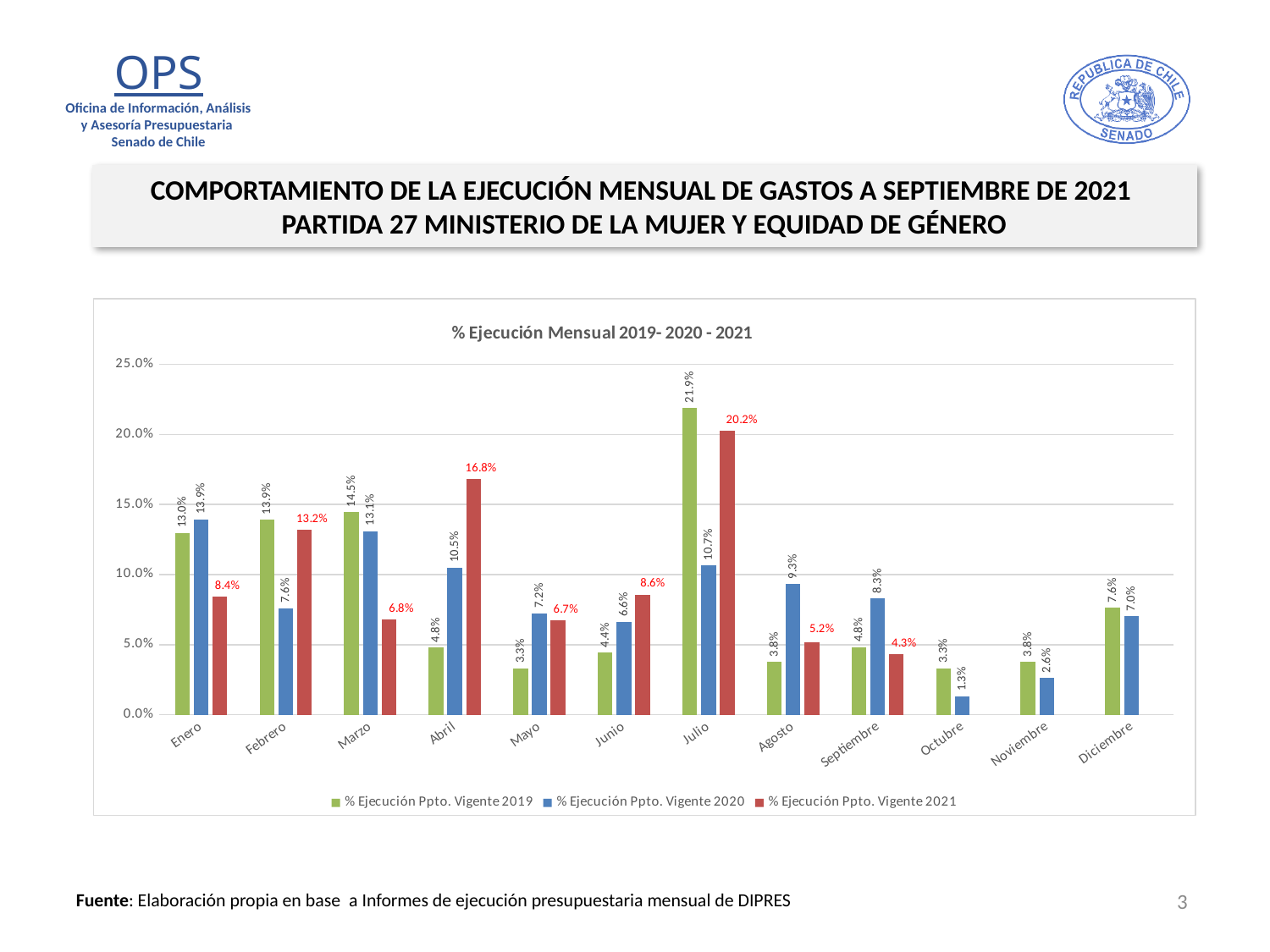
Which month has the lowest value in the % Ejecución Ppto. Vigente 2020 series? Octubre What is the value for Julio in the % Ejecución Ppto. Vigente 2019 series? 21.9% What is the value for Abril in the % Ejecución Ppto. Vigente 2021 series? 16.8% What is the difference between the 2019 and 2021 values for Julio? 1.7% How many months are shown on the x axis? 12 Which month has the highest value in the % Ejecución Ppto. Vigente 2021 series? Julio Is the value for Agosto in the 2020 series greater or less than 5.0%? greater What is the value for Octubre in the % Ejecución Ppto. Vigente 2020 series? 1.3% How many series does the legend list? 3 What kind of chart is shown on the slide? Bar chart Which is larger for Marzo: the 2019 value or the 2020 value? 2019 value (14.5%) What is the title of the chart? % Ejecución Mensual 2019- 2020 - 2021